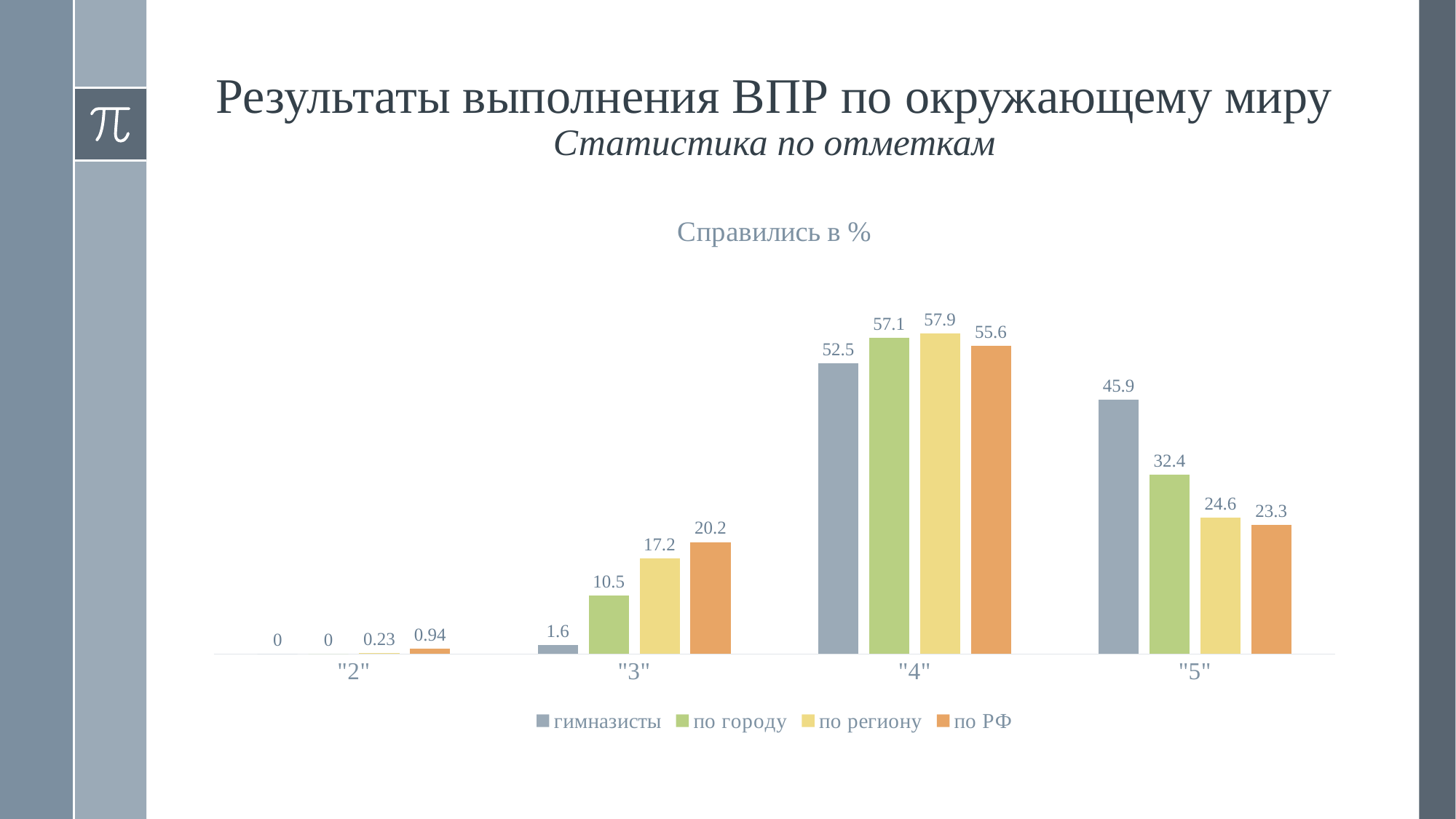
Do the values for по городу rise or fall from "2" to "4"? rise How many series does the legend list? 4 What is the value for по РФ in the "3" category? 20.2 Which series has the lowest value in the "3" category? гимназисты What is the value for гимназисты in the "4" category? 52.5 How many categories are shown on the x axis? 4 What is the value for по региону in the "2" category? 0.23 What kind of chart is shown on the slide? bar chart What is the title of the chart? Справились в % What is the difference between по городу and гимназисты in the "5" category? 13.5 Which series has the highest value in the "5" category? гимназисты Which is larger in the "4" category: по региону or по РФ? по региону